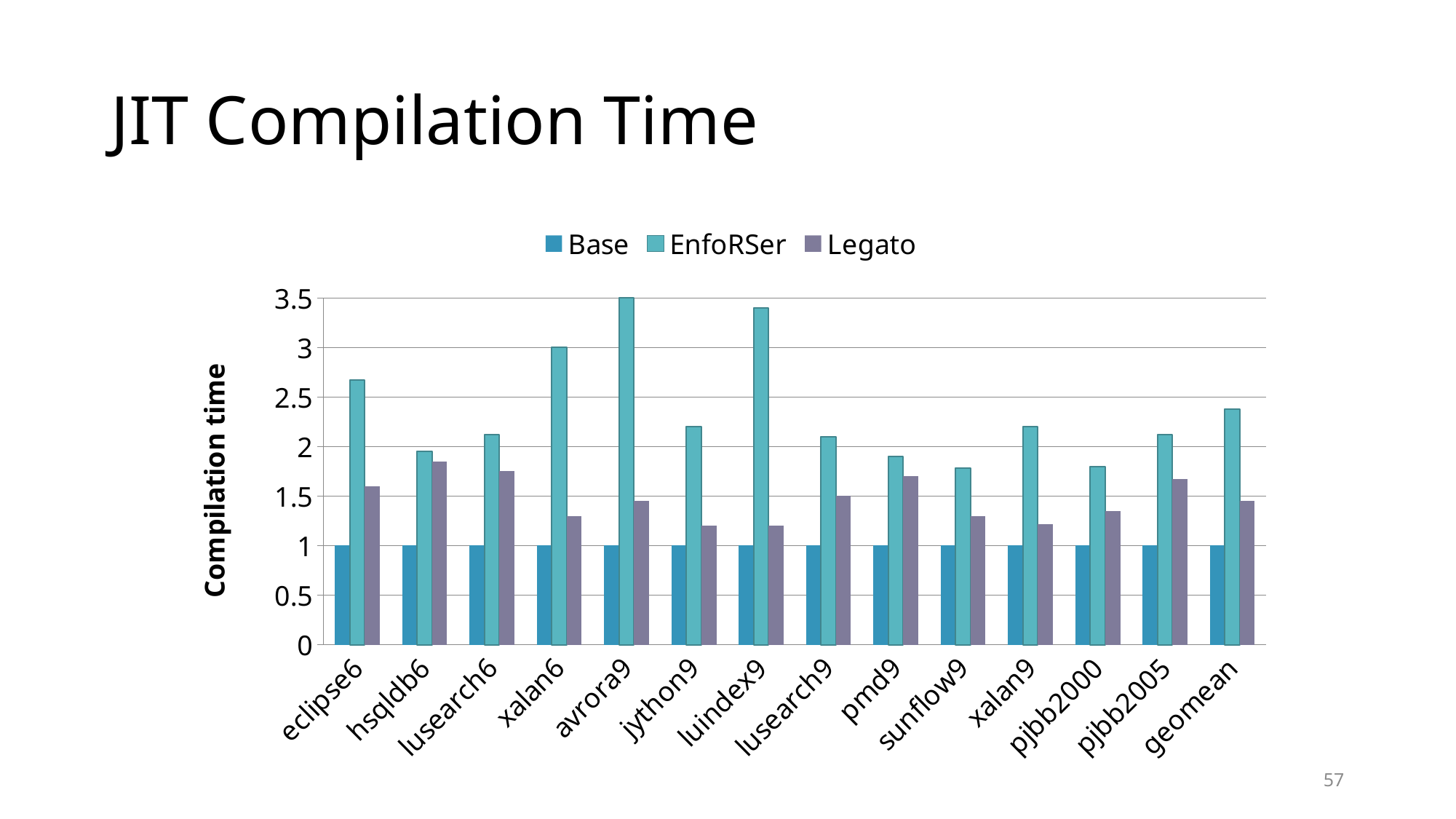
Which is larger, the EnfoRSer value for avrora9 or the EnfoRSer value for jython9? avrora9 What is the label of the y axis? Compilation time Which benchmark has the highest EnfoRSer compilation time? avrora9 How many benchmark categories are shown on the x axis? 14 What is the Base value for eclipse6? 1 How many series does the legend list? 3 Is the EnfoRSer value for geomean greater or less than 2? greater Is the Legato value for xalan6 greater or less than 1.5? less Is the EnfoRSer value for luindex9 greater or less than 3? greater For pmd9, which is larger, the EnfoRSer value or the Legato value? EnfoRSer What is the Base value for geomean? 1 What kind of chart is shown on the slide? bar chart